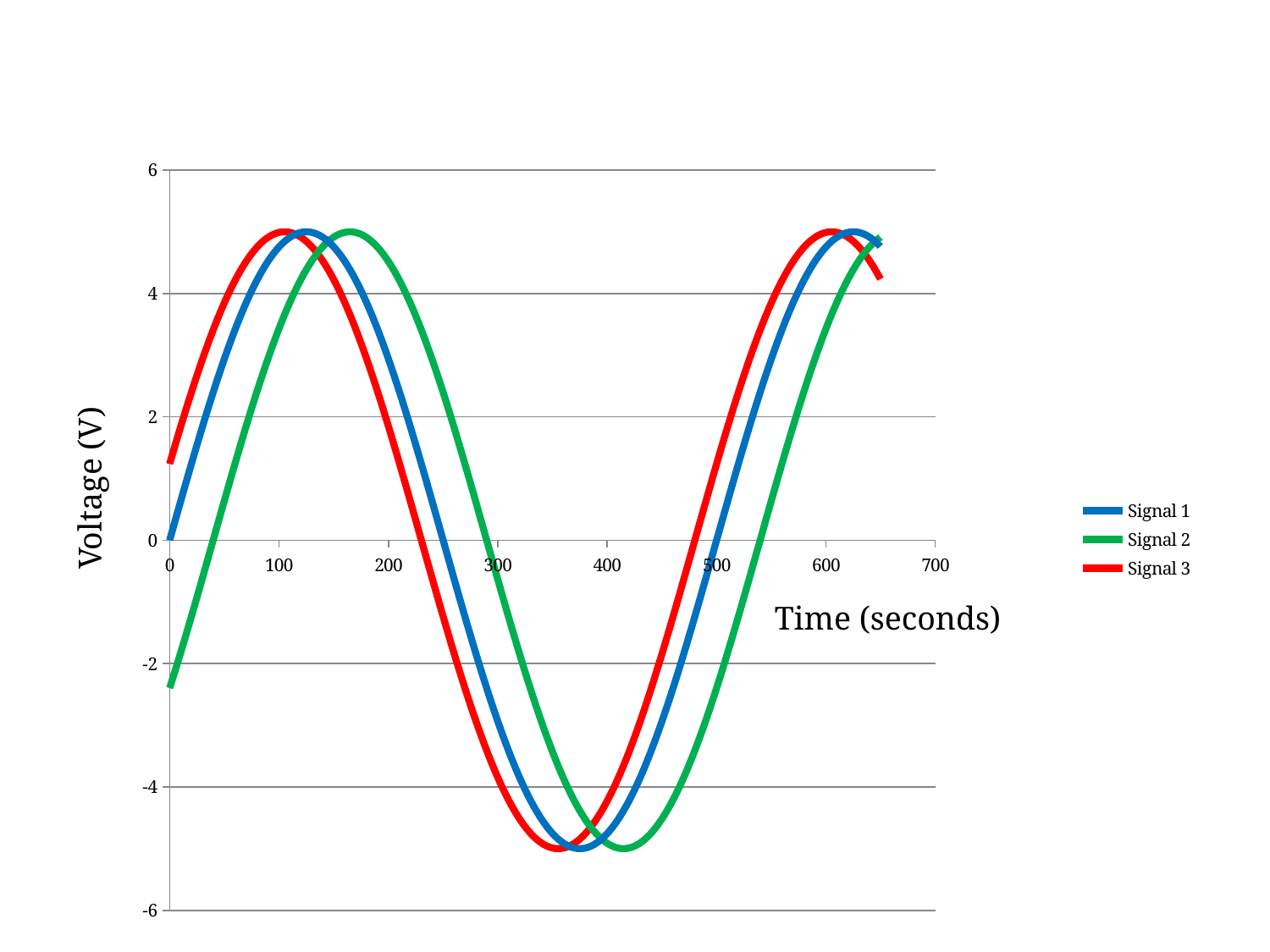
Is the value of Signal 1 at time 100 greater or less than 4? greater Is the value of Signal 2 at time 0 greater or less than 0? less What kind of chart is shown on the slide? line chart What is the value of Signal 1 at time 0? 0 Is the value of Signal 3 at time 0 greater or less than 2? less What is the title of the horizontal axis? Time (seconds) What is the title of the vertical axis? Voltage (V) Does Signal 1 rise or fall between time 200 and time 300? fall How many series does the legend list? 3 Which signal reaches its first peak earliest in time? Signal 3